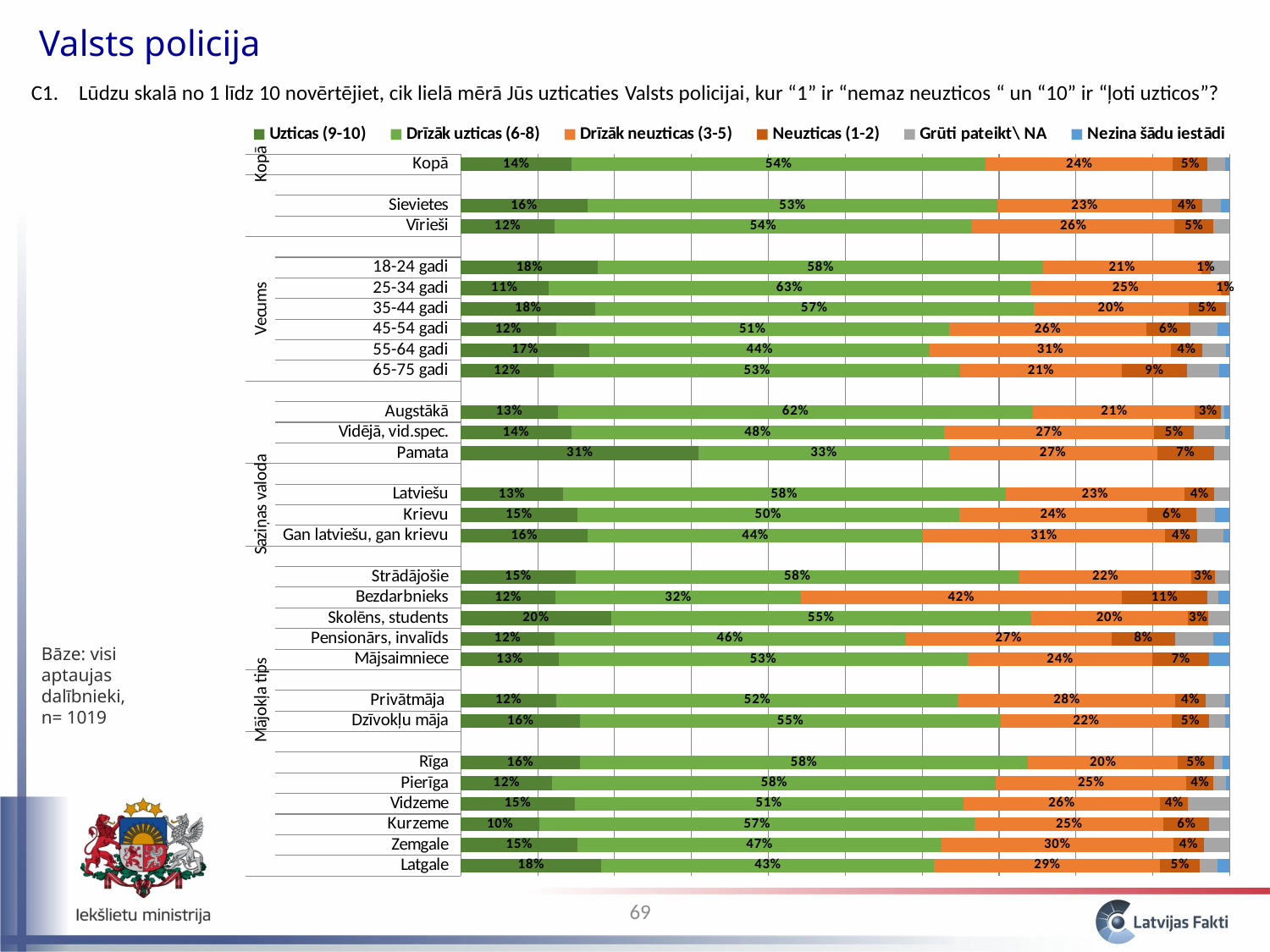
What is the value of Drīzāk neuzticas (3-5) for Bezdarbnieks? 42% What is the value of Drīzāk uzticas (6-8) for the Kopā category? 54% Which category has the highest Drīzāk uzticas (6-8) value? 25-34 gadi What is the value of Uzticas (9-10) for Latgale? 18% How many series does the legend list? 6 What kind of chart is shown on the slide? Stacked bar chart What is the difference in Uzticas (9-10) between Sievietes and Vīrieši? 4 percentage points Which category has the highest Uzticas (9-10) value? Pamata What is the difference in Uzticas (9-10) between Pamata and Kopā? 17 percentage points Which has a larger Drīzāk neuzticas (3-5) value, 55-64 gadi or 18-24 gadi? 55-64 gadi How many age-group (Vecums) categories are shown in the chart? 6 Which category has the lowest Uzticas (9-10) value? Kurzeme